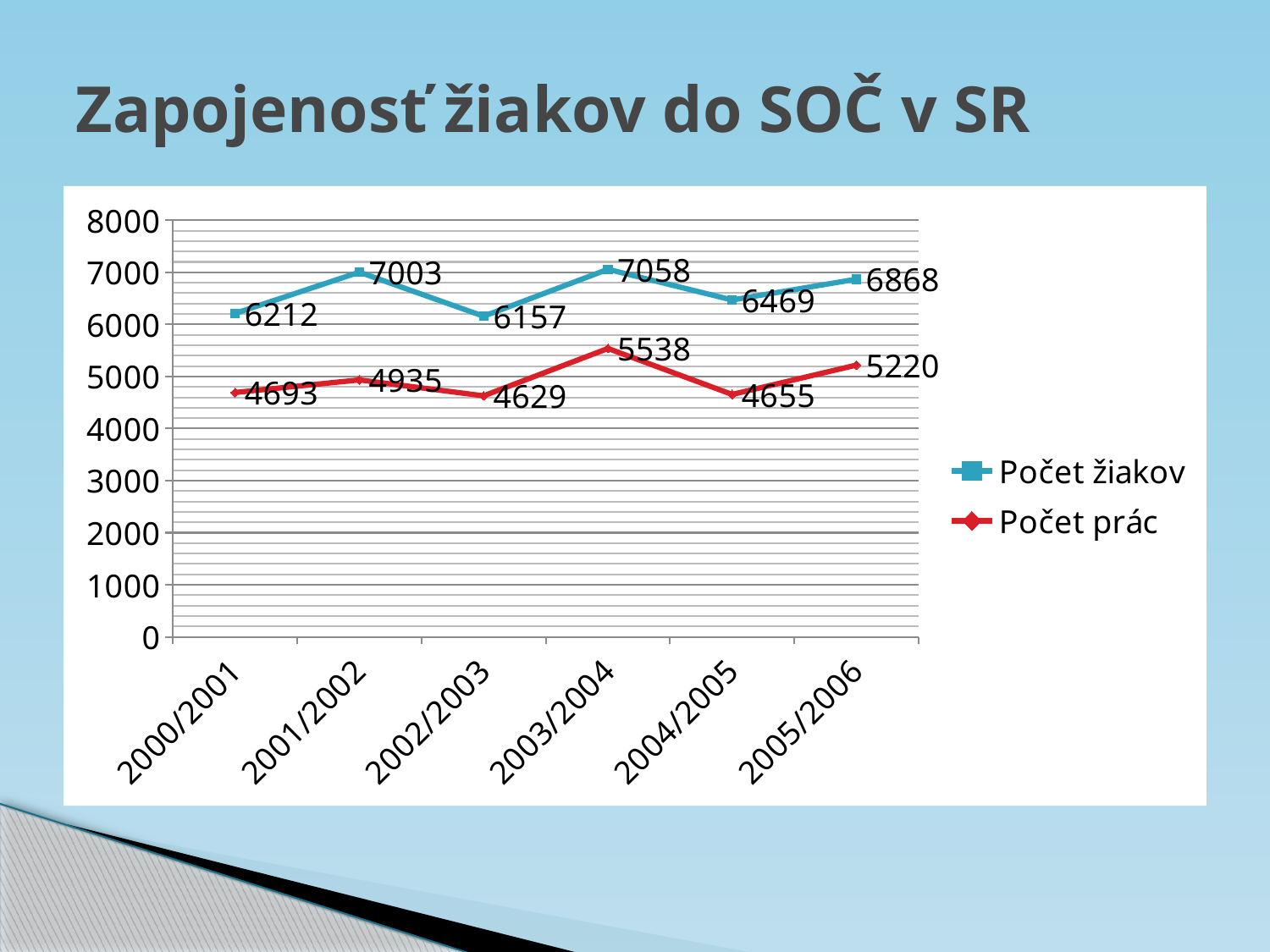
What is the value of Počet žiakov for 2001/2002? 7003 What kind of chart is shown on the slide? line chart What is the difference between Počet žiakov and Počet prác in 2000/2001? 1519 Does Počet žiakov rise or fall from 2004/2005 to 2005/2006? rise In which school year is Počet prác lowest? 2002/2003 How many series does the legend list? 2 Which is larger: Počet prác in 2001/2002 or Počet prác in 2004/2005? Počet prác in 2001/2002 In which school year is Počet žiakov highest? 2003/2004 What is the value of Počet žiakov for 2005/2006? 6868 How many school years are shown on the x axis? 6 What is the value of Počet prác for 2003/2004? 5538 Is the value of Počet žiakov for 2002/2003 greater or less than 6000? greater